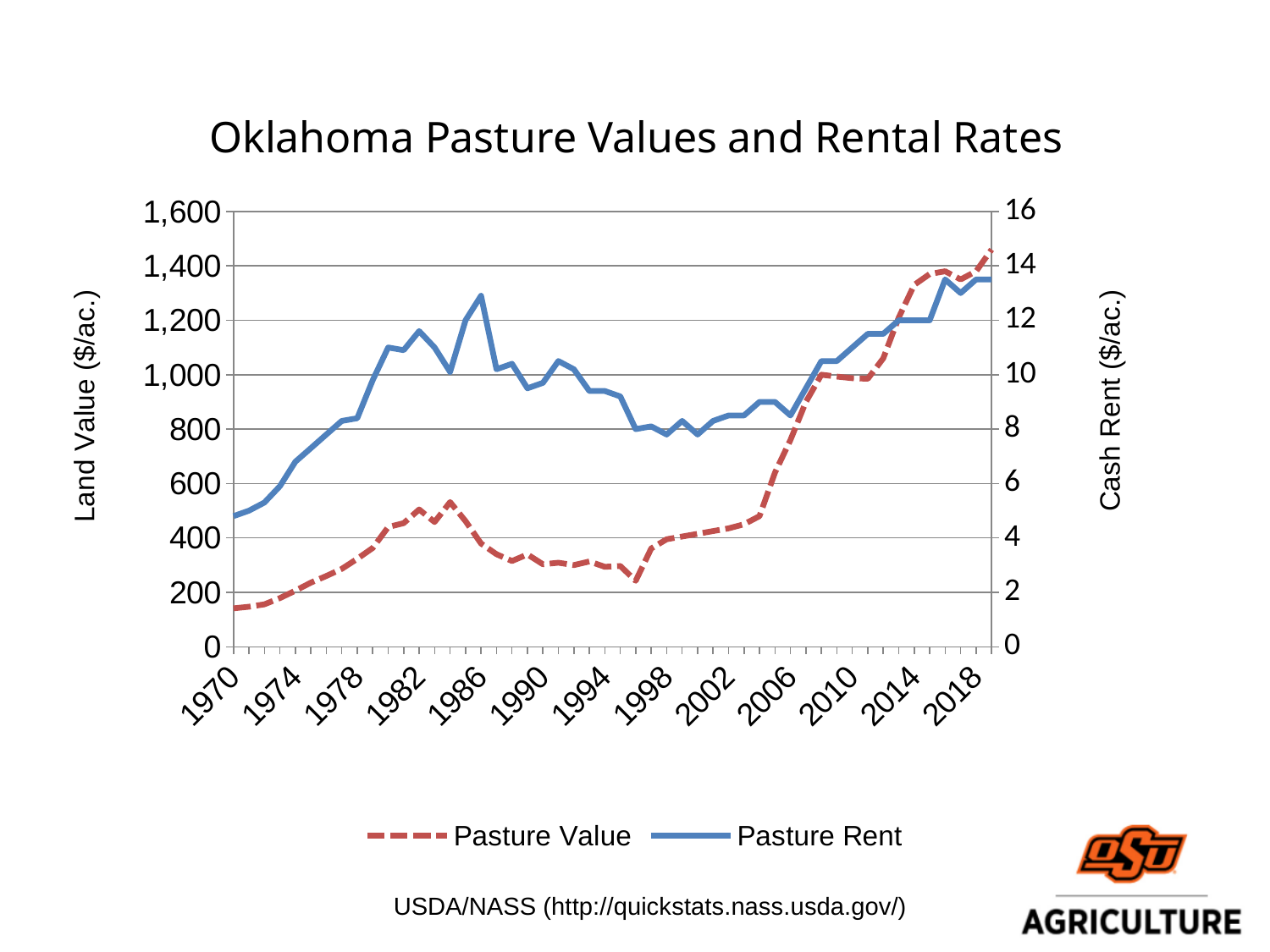
Is the Pasture Value in 1970 greater or less than 200? less Does the Pasture Value line rise or fall between 2002 and 2018? rise In which labelled year is Pasture Rent at its lowest? 1970 What kind of chart is shown on the slide? line chart Is the Pasture Rent in 1998 greater or less than 10? less Does the Pasture Rent line rise or fall between 1986 and 1998? fall What is the title of the chart? Oklahoma Pasture Values and Rental Rates How many series does the legend list? 2 What is the label of the right-hand vertical axis? Cash Rent ($/ac.) Is the Pasture Value in 2018 greater or less than 1,200? greater